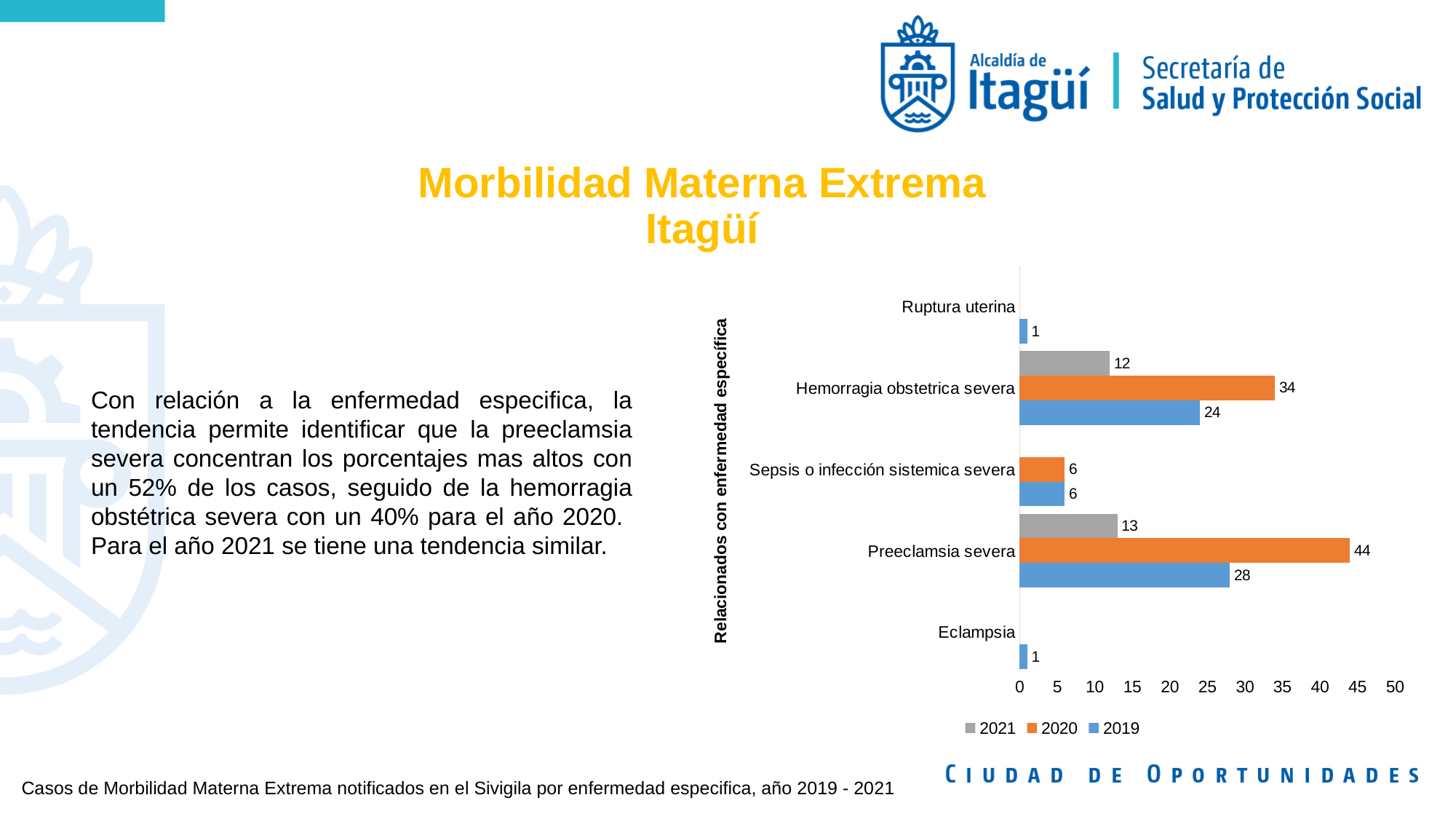
What is the 2021 value for Hemorragia obstetrica severa? 12 What is the 2020 value for Preeclamsia severa? 44 Which is larger for Hemorragia obstetrica severa, the 2020 value or the 2021 value? 2020 What is the 2019 value for Eclampsia? 1 What is the 2019 value for Hemorragia obstetrica severa? 24 Which category has the highest 2020 value? Preeclamsia severa What is the difference between the 2020 values for Preeclamsia severa and Hemorragia obstetrica severa? 10 What kind of chart is shown on the slide? Bar chart How many categories are shown on the vertical axis of the chart? 5 How many series does the legend list? 3 What is the difference between the 2020 and 2019 values for Preeclamsia severa? 16 Which series is shown in orange in the legend? 2020